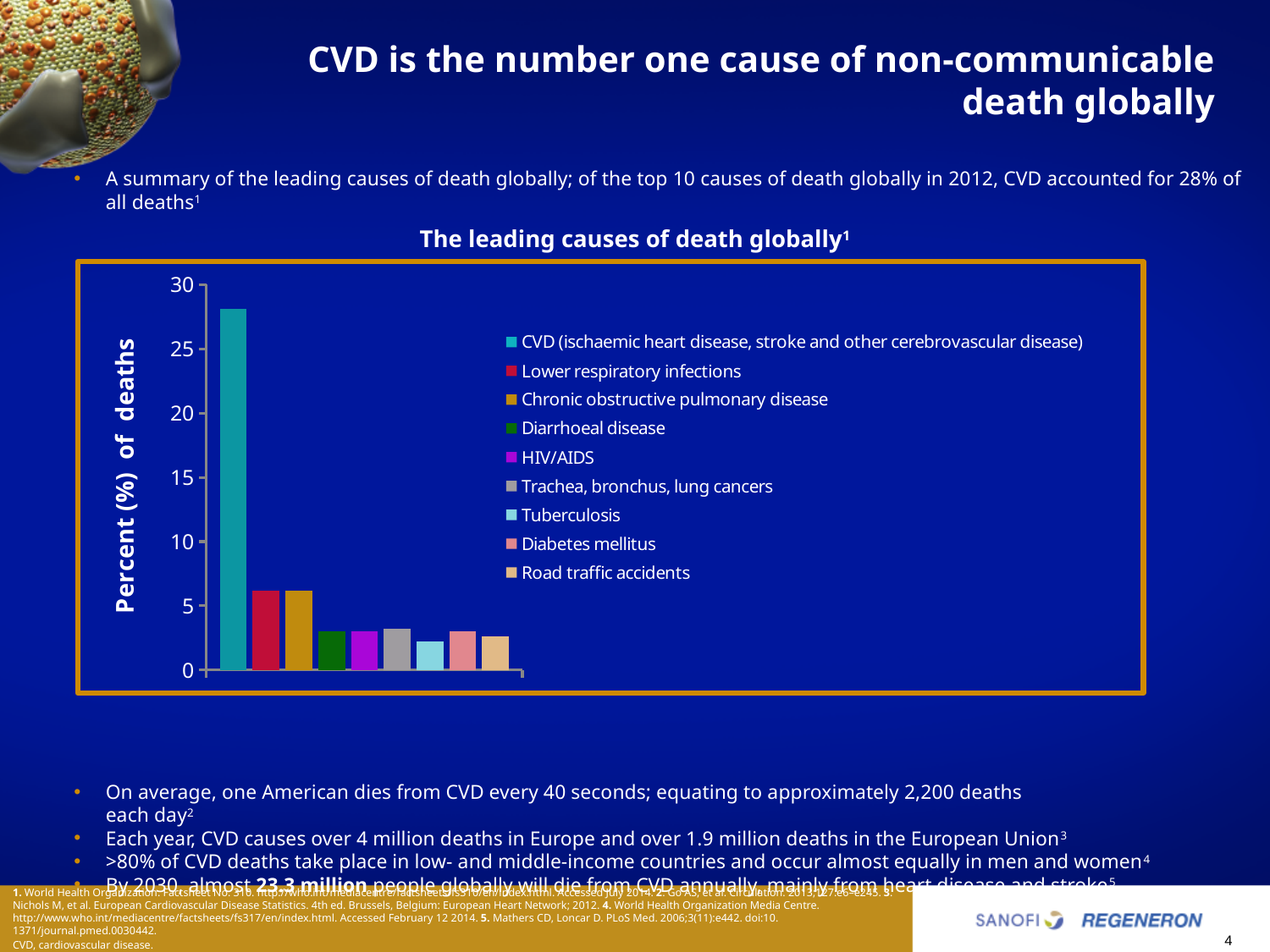
How many series does the legend of the chart list? 9 Is the value for Diarrhoeal disease greater or less than 10? less Which cause of death has the highest percentage of deaths in the chart? CVD (ischaemic heart disease, stroke and other cerebrovascular disease) Is the value for Lower respiratory infections greater or less than 5? greater Which is larger, the value for Chronic obstructive pulmonary disease or the value for HIV/AIDS? Chronic obstructive pulmonary disease What is the label of the vertical axis of the chart? Percent (%) of deaths Is the value for CVD greater or less than 25? greater What is the title of the chart? The leading causes of death globally How many bars are plotted in the chart? 9 What kind of chart is shown on the slide? bar chart Which is larger, the value for CVD or the value for Lower respiratory infections? CVD